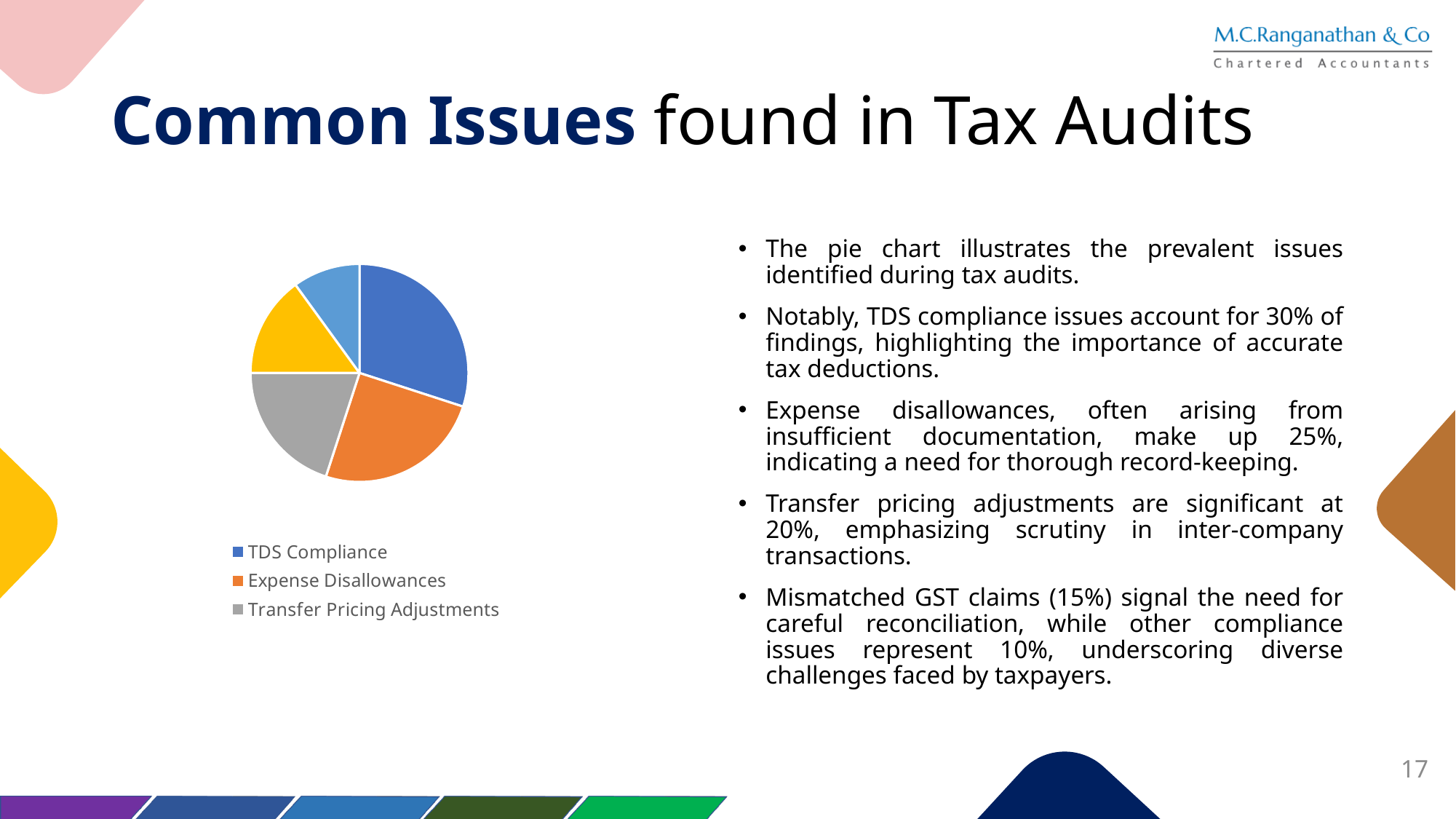
By how many percentage points does TDS Compliance exceed Expense Disallowances? 5 percentage points How many slices does the pie chart have? 5 What colour is the Expense Disallowances slice in the pie chart? Orange Which category has the largest slice in the pie chart? TDS Compliance Which slice is larger, Expense Disallowances or Transfer Pricing Adjustments? Expense Disallowances What kind of chart is shown on the slide? Pie chart What share of the pie does Transfer Pricing Adjustments represent? 20% How many entries does the pie chart's legend list? 3 What share of the pie does Expense Disallowances represent? 25% What share of the pie does TDS Compliance represent? 30% Which slice is larger, TDS Compliance or Transfer Pricing Adjustments? TDS Compliance Which legend entry is shown in blue? TDS Compliance